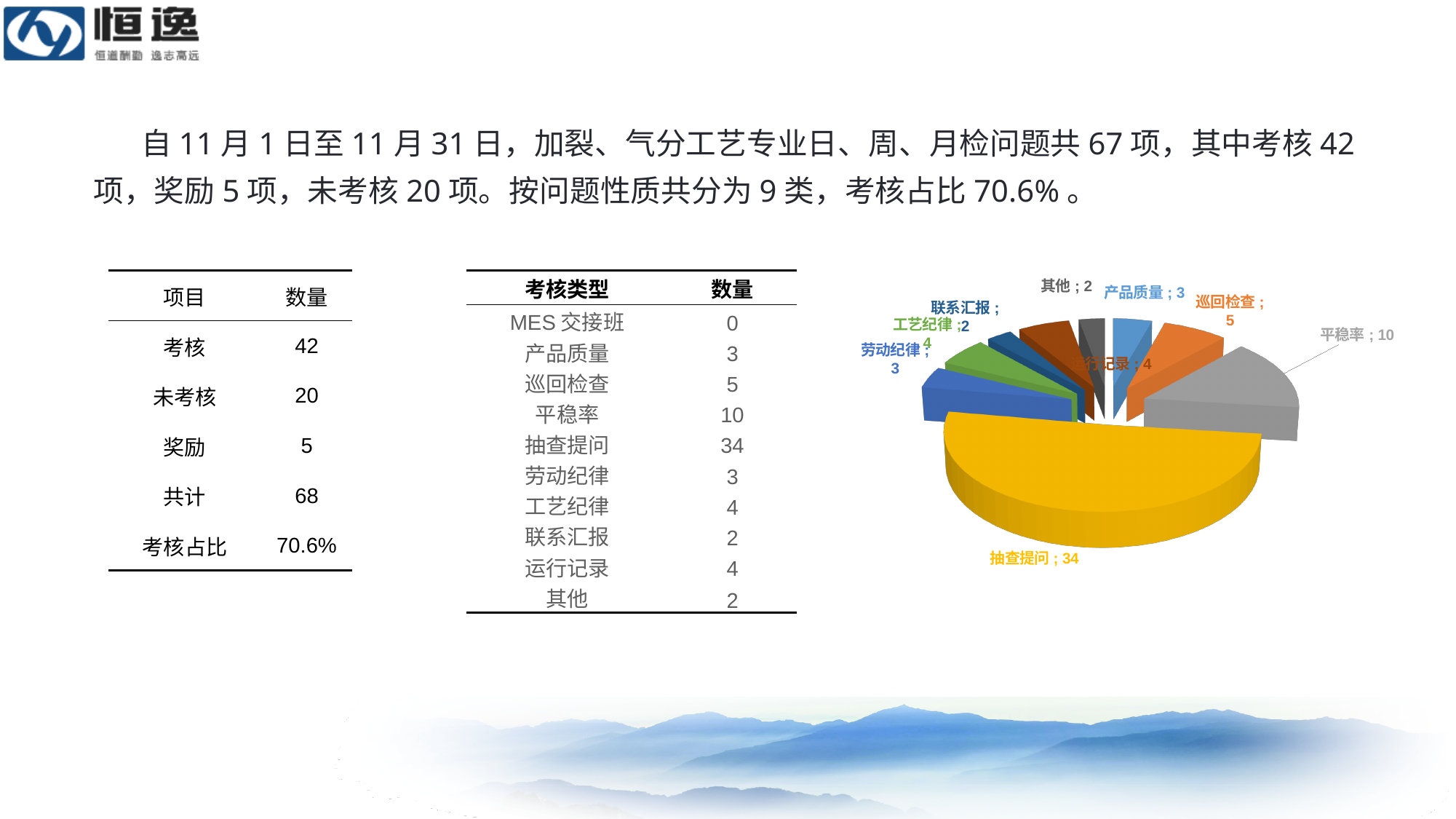
In the pie chart, what is the value shown for 平稳率? 10 In the pie chart, what is the value shown for 抽查提问? 34 In the pie chart, what is the difference between the values for 平稳率 and 巡回检查? 5 In the pie chart, which is larger: 工艺纪律 or 劳动纪律? 工艺纪律 What colour is the 抽查提问 slice in the pie chart? Yellow In the pie chart, which is larger: 巡回检查 or 产品质量? 巡回检查 In the pie chart, what is the value shown for 工艺纪律? 4 Which category has the largest slice in the pie chart? 抽查提问 In the pie chart, what is the value shown for 巡回检查? 5 What kind of chart is shown on the slide? Pie chart How many slices are labelled in the pie chart? 9 In the pie chart, what is the difference between the values for 抽查提问 and 平稳率? 24